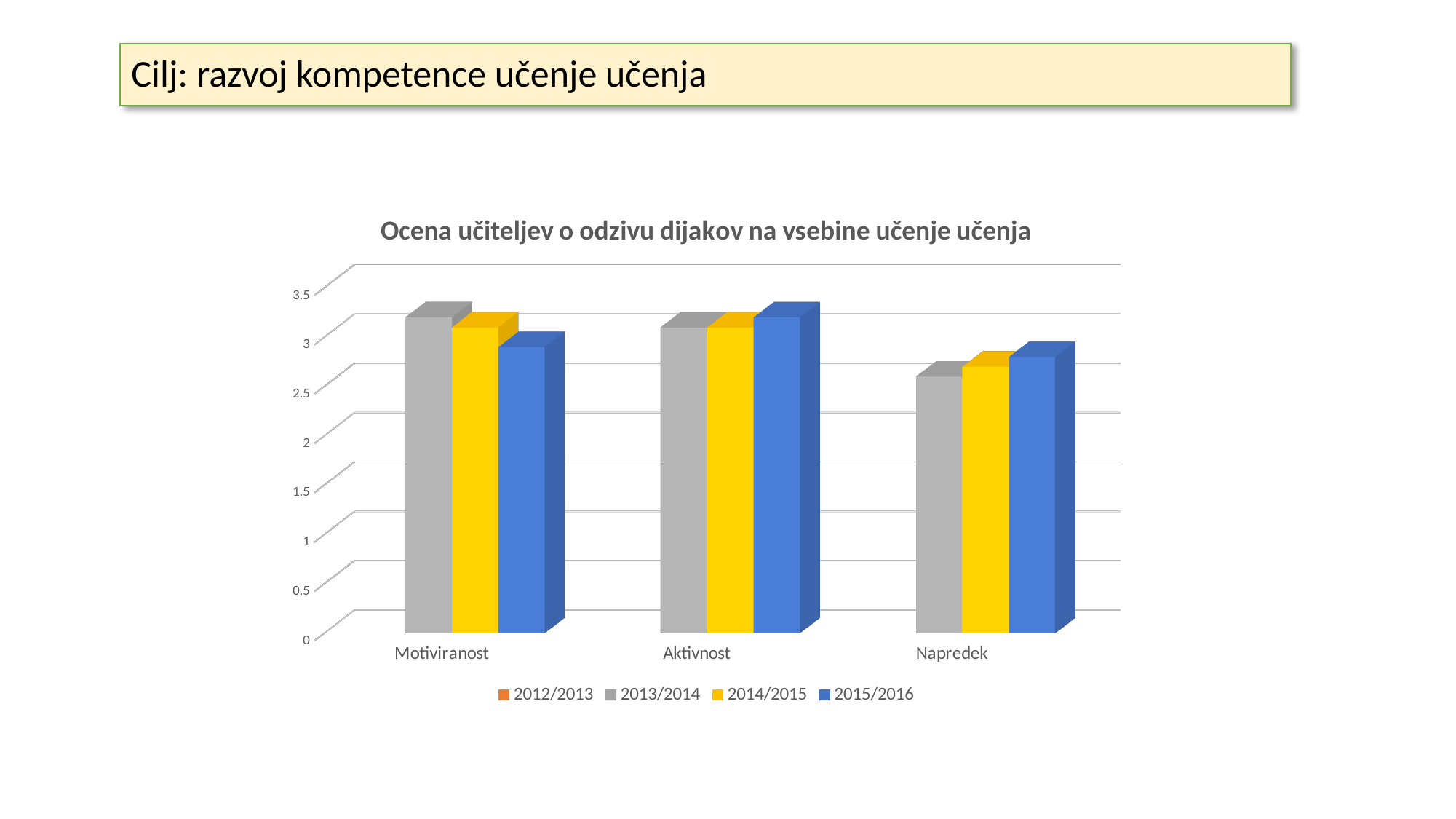
In the 2013/2014 series, which is larger: the value for Motiviranost or the value for Napredek? Motiviranost Is the value for Napredek in the 2015/2016 series greater or less than 3.5? less What is the title of the chart? Ocena učiteljev o odzivu dijakov na vsebine učenje učenja How many categories are shown on the x axis of the chart? 3 Is the value for Motiviranost in the 2013/2014 series greater or less than 2.5? greater Is the value for Napredek in the 2013/2014 series greater or less than 3? less For the 2013/2014 series, which category has the lowest value? Napredek How many series does the chart legend list? 4 Which series is shown in yellow in the chart? 2014/2015 For the category Napredek, which is larger: the 2013/2014 value or the 2015/2016 value? 2015/2016 What kind of chart is shown on the slide? bar chart